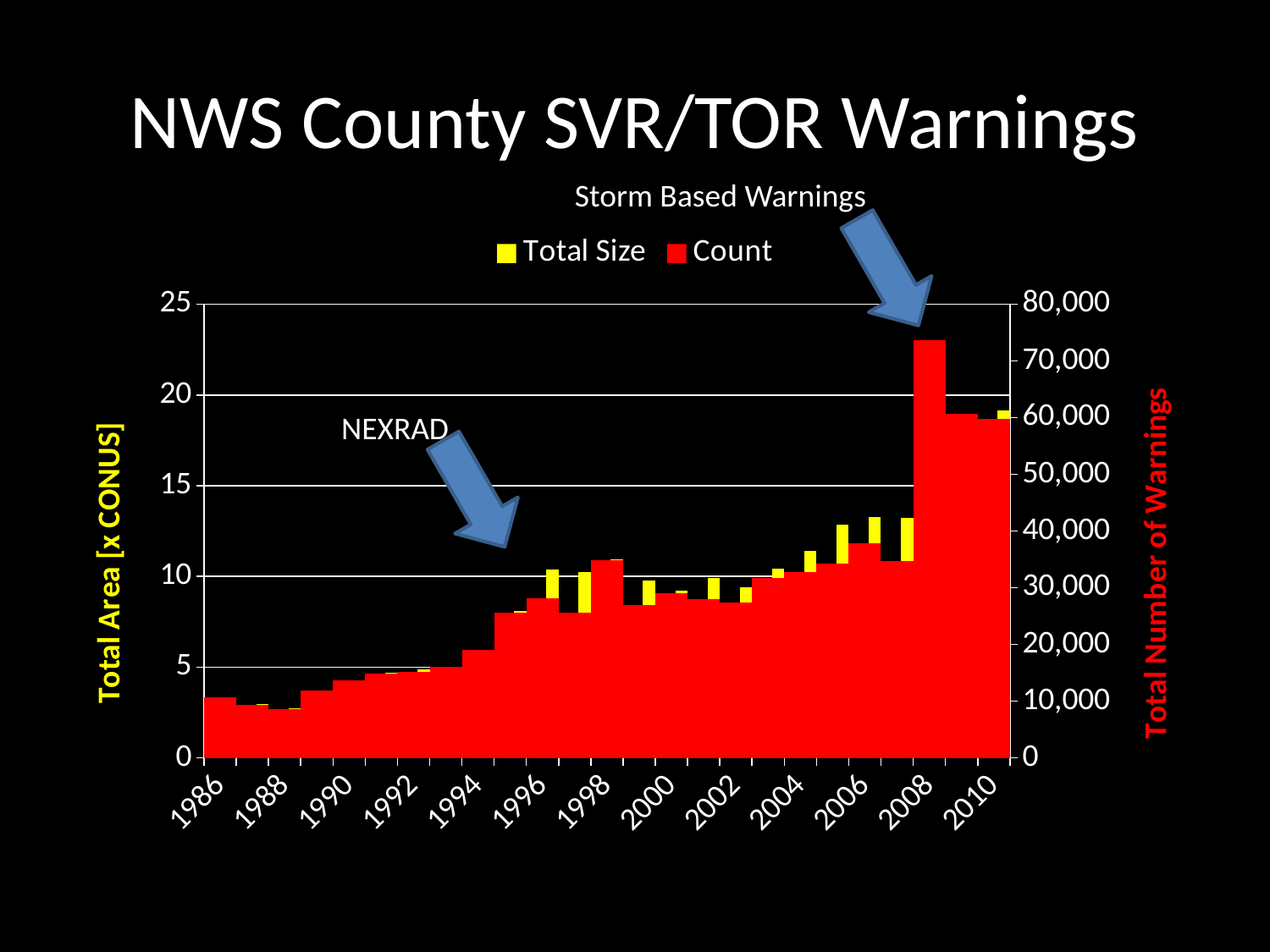
Which year has the larger Count, 1998 or 2008? 2008 Is the Total Size for 2007 greater or less than 10? greater In which year is the Count highest? 2008 Overall, does the Count rise or fall from 1986 to 2010? rise How many series does the legend list? 2 Is the Count for 1990 greater or less than 10,000? greater What is the title of the right-hand vertical axis? Total Number of Warnings Is the Count for 1998 greater or less than 30,000? greater What kind of chart is shown on the slide? bar chart Which series is shown in yellow in the legend? Total Size